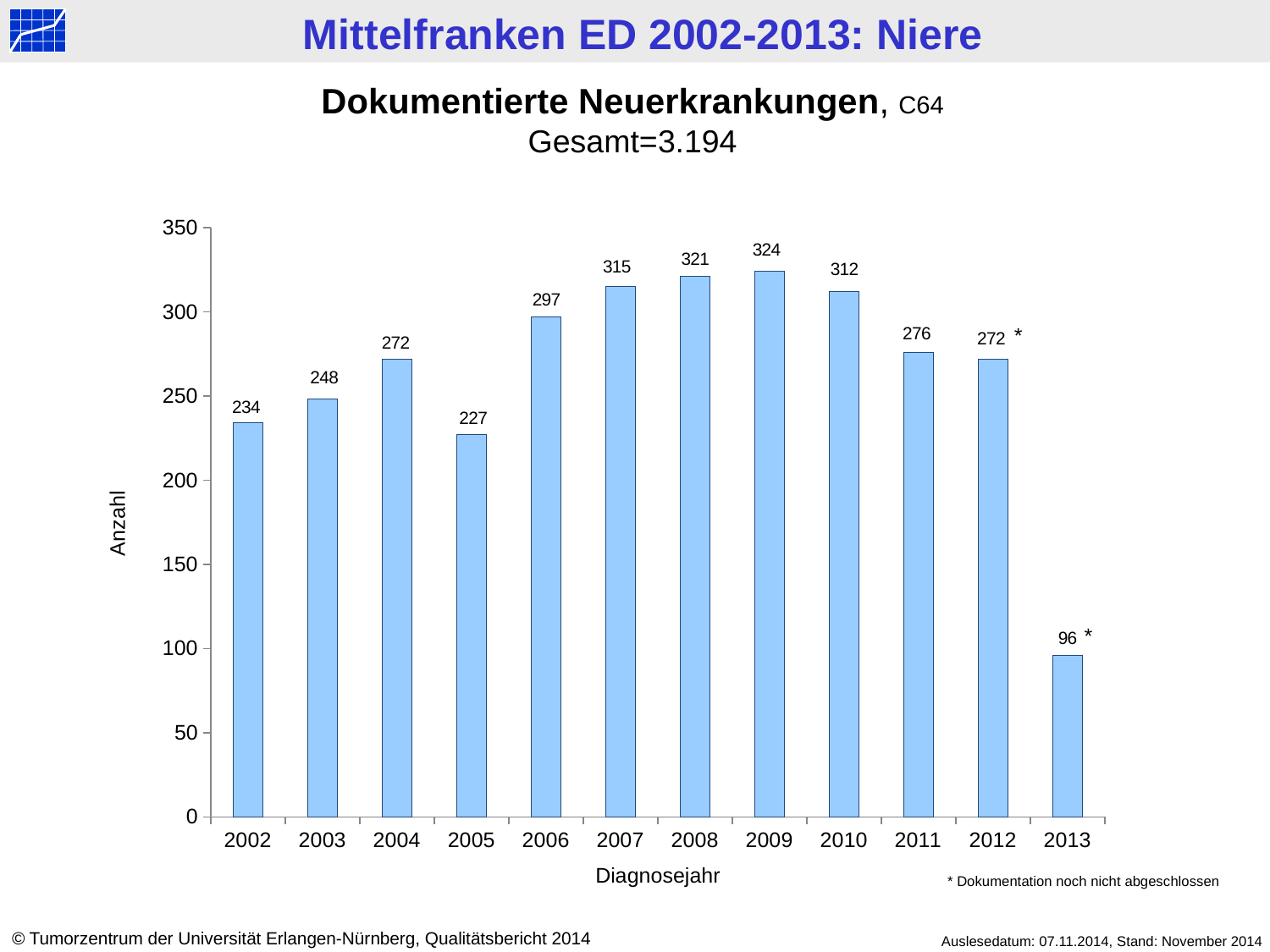
What is the label of the y axis? Anzahl Which year has the lowest value? 2013 Do the values rise or fall from 2005 to 2009? rise Which year has the highest value? 2009 What is the value for 2013? 96 Is the value for 2010 greater or less than 300? greater What kind of chart is shown? bar chart How many years are shown on the x axis? 12 What is the value for 2009? 324 What is the difference between the values for 2009 and 2002? 90 What is the value for 2005? 227 Which is larger, the value for 2006 or the value for 2011? 2006